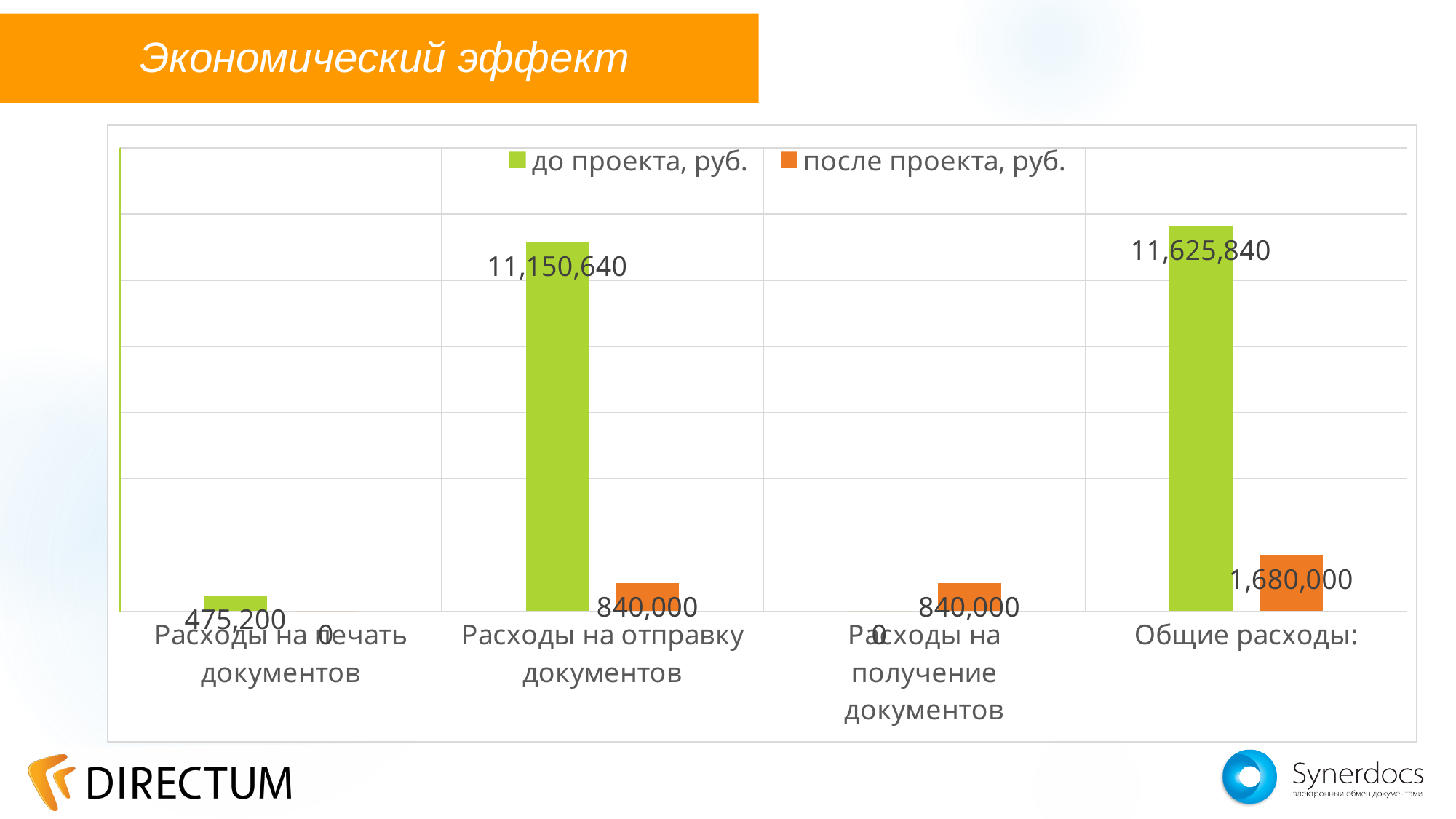
What is the value of "до проекта, руб." for "Расходы на получение документов"? 0 What is the difference between "до проекта, руб." and "после проекта, руб." for "Общие расходы:"? 9,945,840 What is the value of "до проекта, руб." for "Расходы на печать документов"? 475,200 How many categories are shown on the x axis? 4 What colour are the bars for the "после проекта, руб." series? Orange What is the value of "до проекта, руб." for "Расходы на отправку документов"? 11,150,640 What is the value of "после проекта, руб." for "Общие расходы:"? 1,680,000 Which category has the highest value for "до проекта, руб."? Общие расходы: For "Расходы на получение документов", which is larger: "до проекта, руб." or "после проекта, руб."? после проекта, руб. What is the value of "после проекта, руб." for "Расходы на отправку документов"? 840,000 How many series does the legend list? 2 What type of chart is shown on the slide? Bar chart